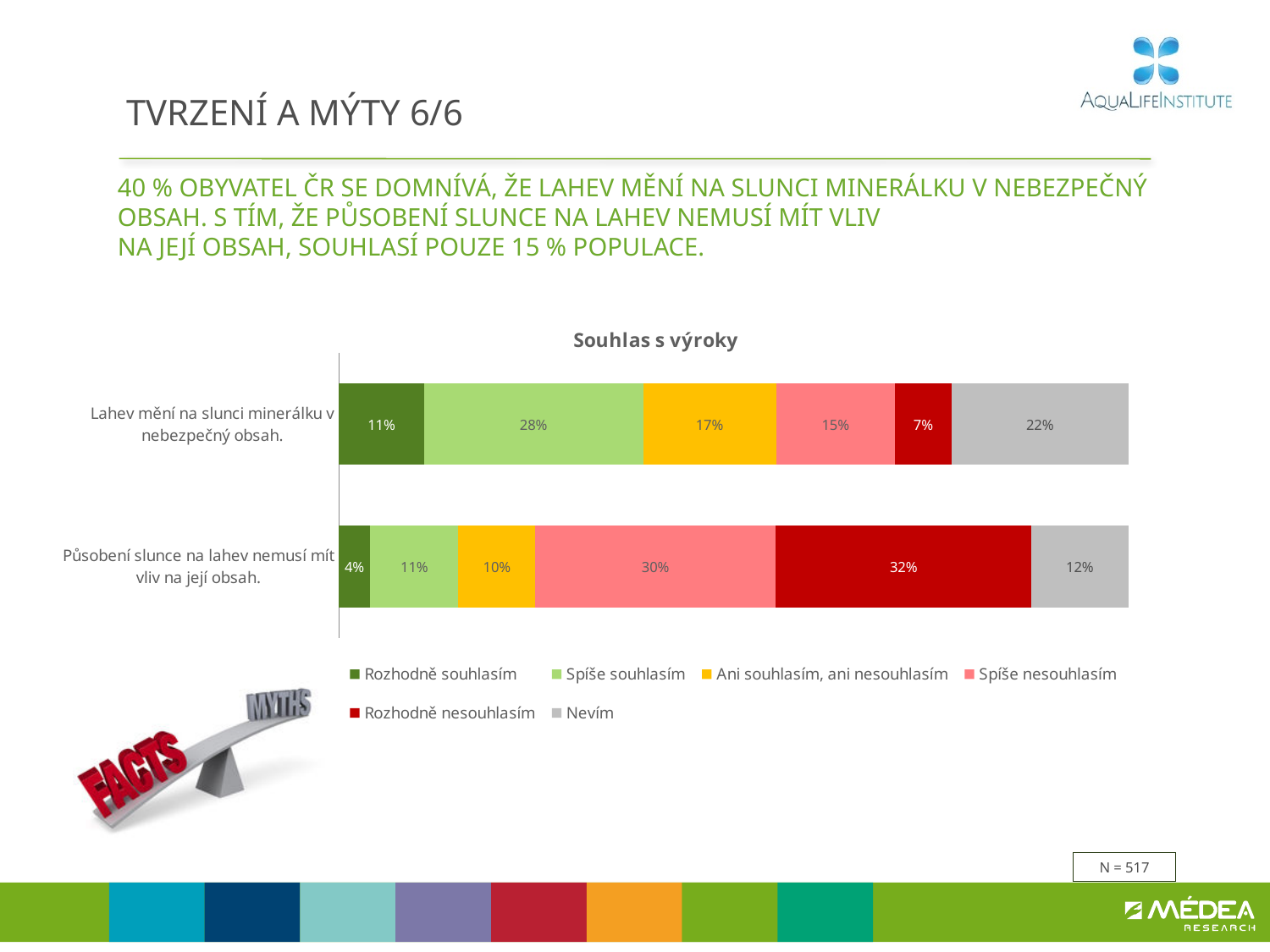
What is the difference between 'Spíše nesouhlasím' for 'Působení slunce na lahev nemusí mít vliv na její obsah.' and 'Spíše nesouhlasím' for 'Lahev mění na slunci minerálku v nebezpečný obsah.'? 15% What is the title of the chart? Souhlas s výroky What is the value of 'Nevím' for 'Lahev mění na slunci minerálku v nebezpečný obsah.'? 22% What is the value of 'Spíše souhlasím' for 'Lahev mění na slunci minerálku v nebezpečný obsah.'? 28% Which series has the lowest value for 'Lahev mění na slunci minerálku v nebezpečný obsah.'? Rozhodně nesouhlasím How many categories (statements) are plotted in the chart? 2 What kind of chart is shown on the slide? Stacked bar chart What is the value of 'Rozhodně nesouhlasím' for 'Působení slunce na lahev nemusí mít vliv na její obsah.'? 32% Which is larger: 'Ani souhlasím, ani nesouhlasím' for 'Lahev mění na slunci minerálku v nebezpečný obsah.' or for 'Působení slunce na lahev nemusí mít vliv na její obsah.'? Lahev mění na slunci minerálku v nebezpečný obsah. What is the value of 'Rozhodně souhlasím' for 'Působení slunce na lahev nemusí mít vliv na její obsah.'? 4% How many series does the legend list? 6 Which series has the highest value for 'Působení slunce na lahev nemusí mít vliv na její obsah.'? Rozhodně nesouhlasím